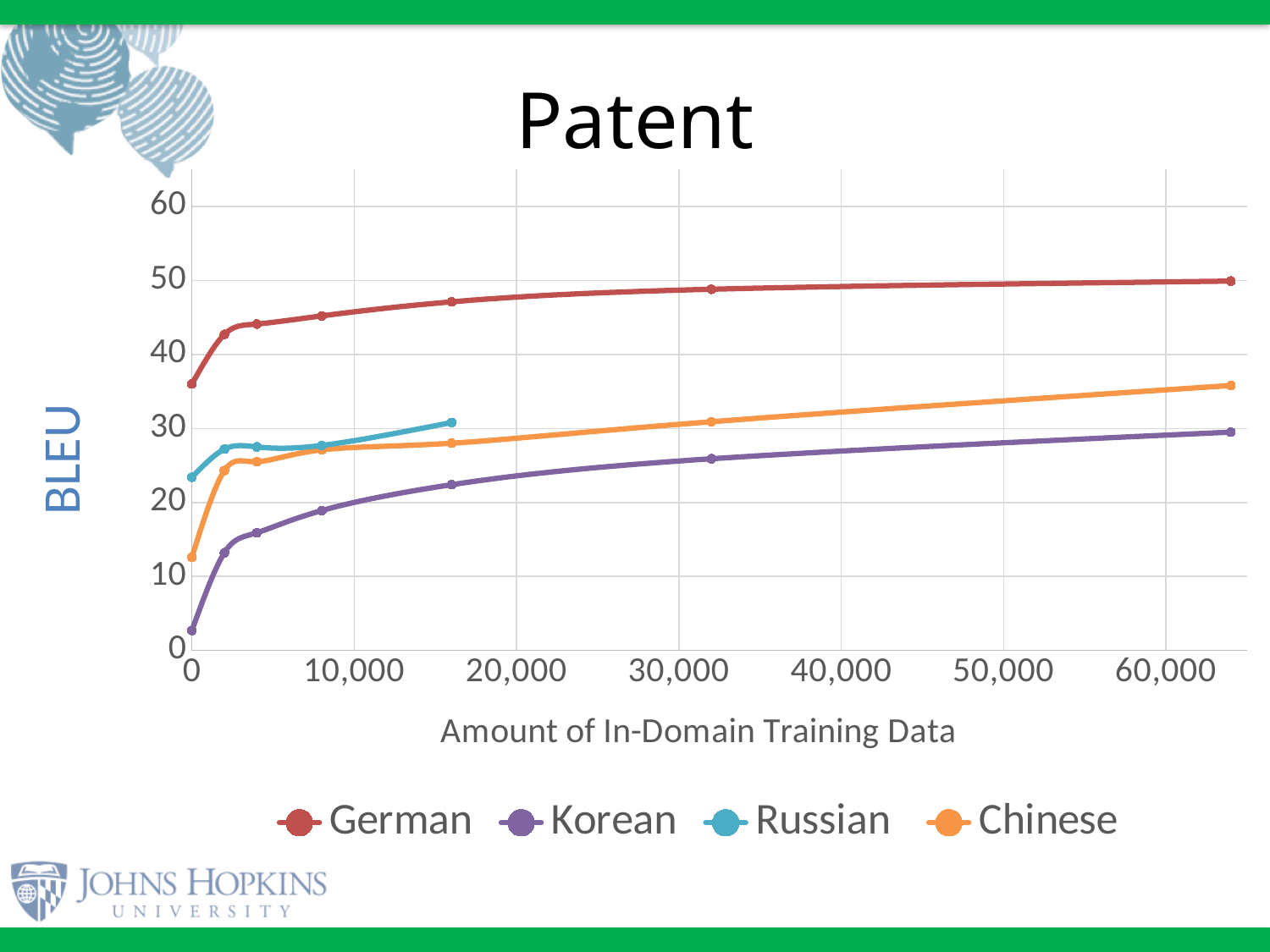
Is the BLEU value for German at 0 in-domain training data greater or less than 30? greater Is the BLEU value for Korean at about 30,000 in-domain training data greater or less than 20? greater Which language has the highest BLEU scores across the chart? German Is the BLEU value for Chinese at about 60,000 in-domain training data greater or less than 30? greater What kind of chart is shown on the slide? line chart What is the label of the y axis? BLEU Do the BLEU scores rise or fall as the amount of in-domain training data increases? rise What is the title of the chart? Patent Which language has the lowest BLEU scores across the chart? Korean How many series does the legend list? 4 At about 60,000 in-domain training data, which has the higher BLEU score, Chinese or Korean? Chinese